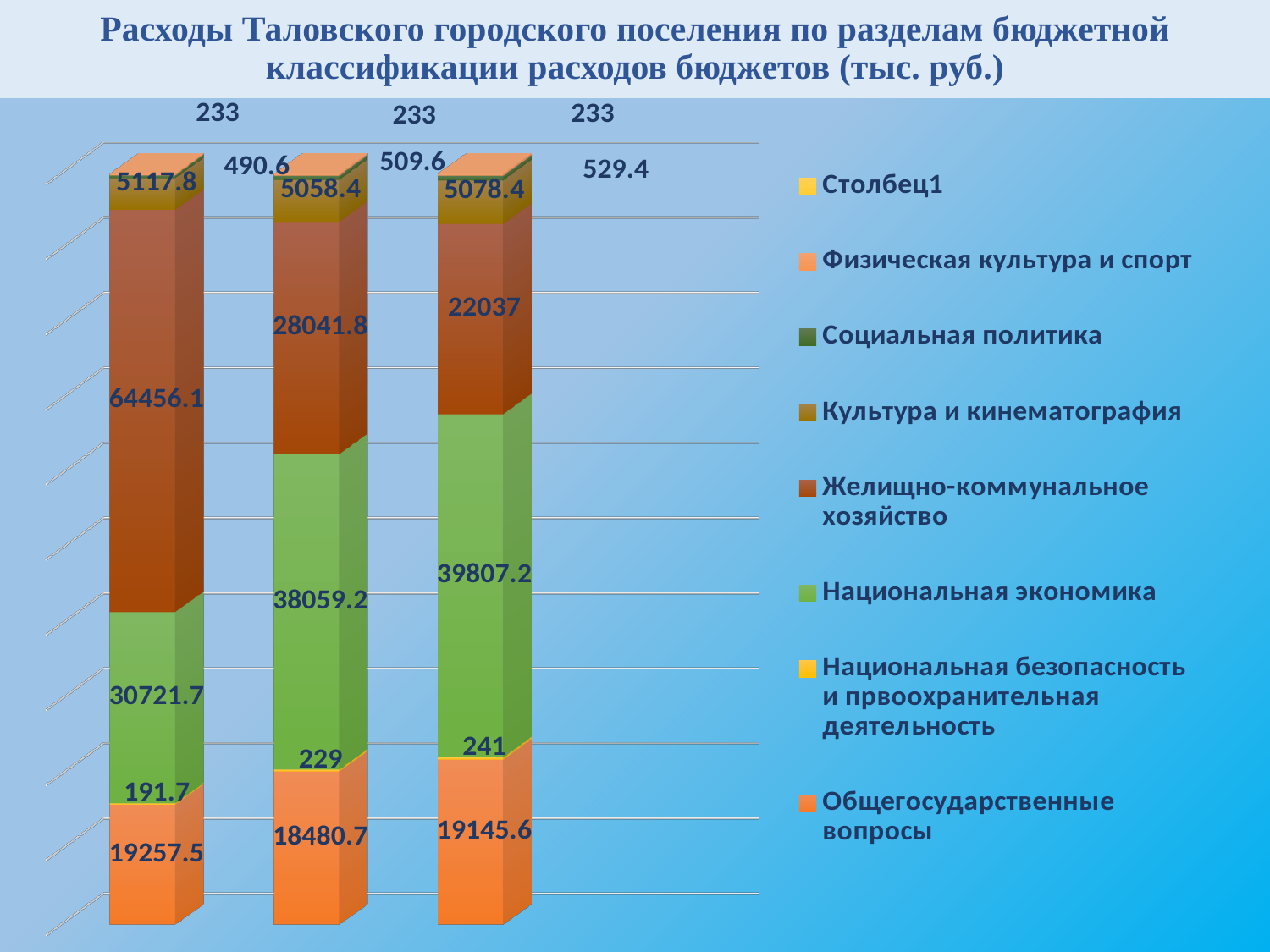
How many bars are plotted in the chart? 3 Which is larger: Общегосударственные вопросы in the left bar or in the middle bar? The left bar (19257.5) What is the value of Желищно-коммунальное хозяйство in the right bar? 22037 What is the title of the chart? Расходы Таловского городского поселения по разделам бюджетной классификации расходов бюджетов (тыс. руб.) Which bar has the highest value for Желищно-коммунальное хозяйство? The left bar (64456.1) What is the difference between the Национальная экономика values in the right bar and the left bar? 9085.5 What is the value of Культура и кинематография in the middle bar? 5058.4 What is the value of Национальная экономика in the middle bar? 38059.2 What is the value of Национальная безопасность и првоохранительная деятельность in the right bar? 241 What kind of chart is shown on the slide? Stacked bar chart What is the value of Общегосударственные вопросы in the left bar? 19257.5 How many series does the legend list? 8